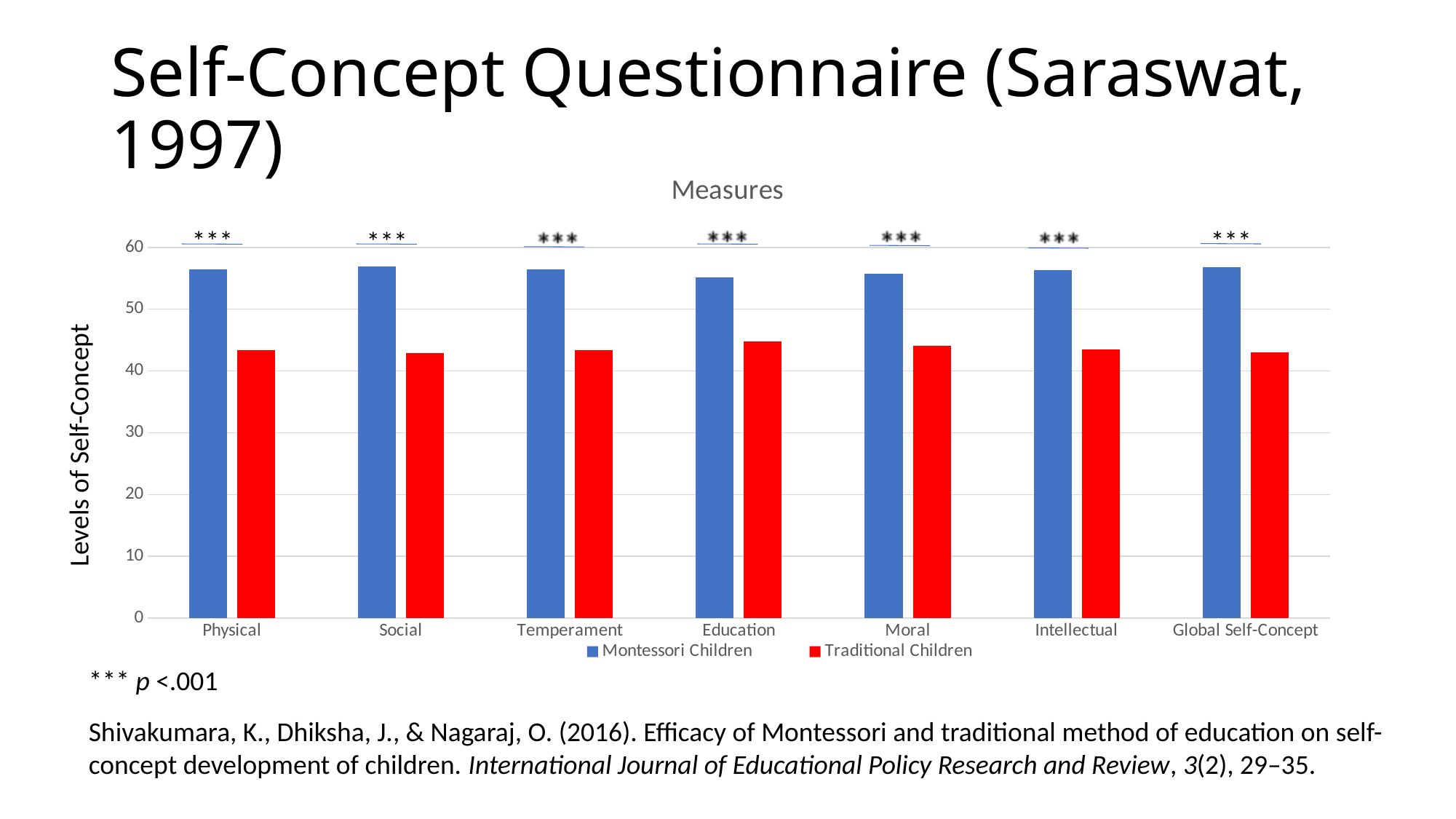
What is the label on the vertical axis? Levels of Self-Concept Is the value for Traditional Children on Physical greater or less than 50? less What kind of chart is shown on the slide? bar chart Is the value for Traditional Children on Education greater or less than 40? greater Which is larger for Social: Montessori Children or Traditional Children? Montessori Children Which series has the lower value for Moral? Traditional Children How many series does the legend list? 2 Which is larger for Global Self-Concept: Montessori Children or Traditional Children? Montessori Children Is the value for Montessori Children on Physical greater or less than 50? greater How many categories are shown on the x axis? 7 What is the title of the chart? Measures